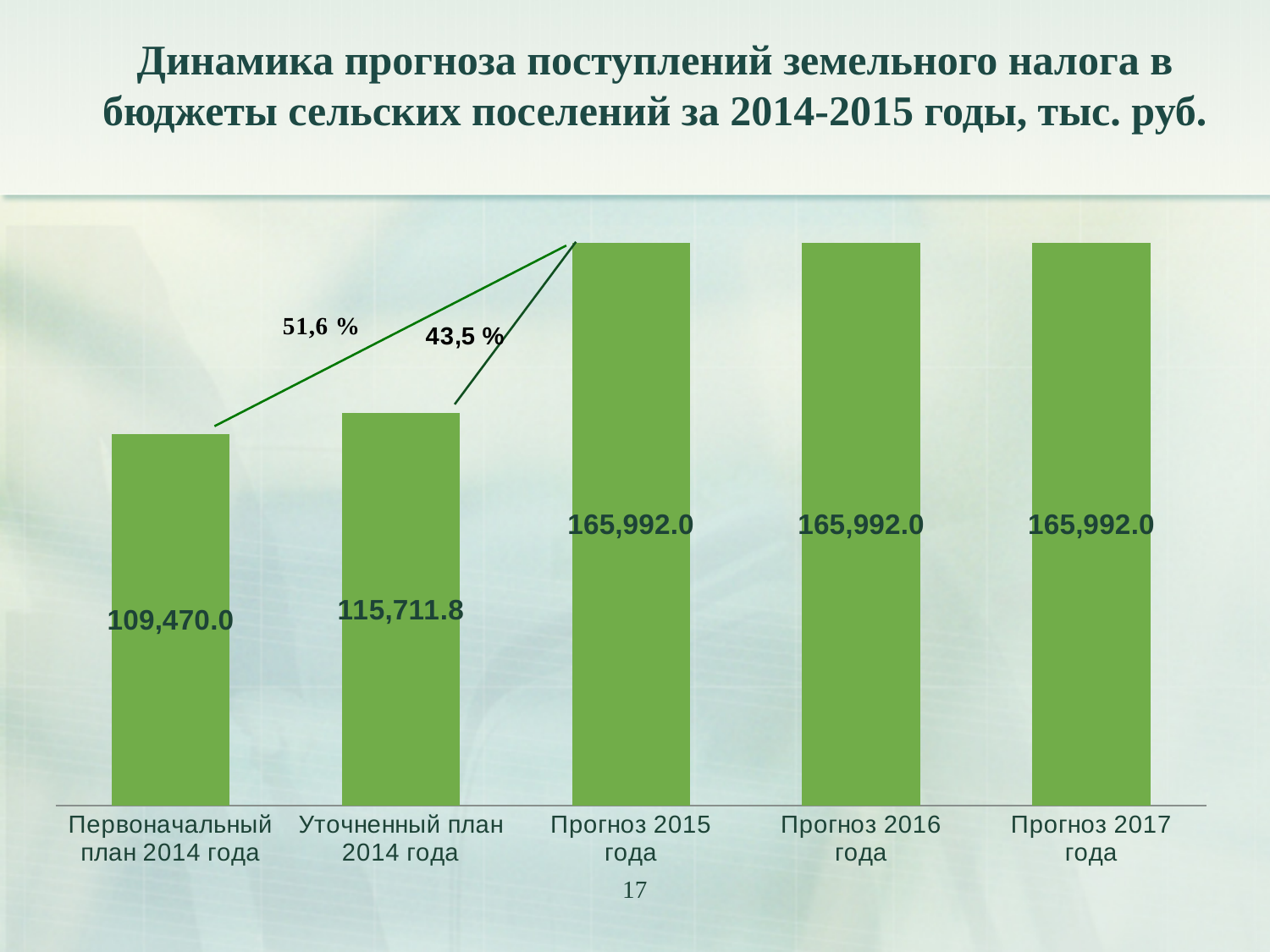
Do the values rise or fall from Первоначальный план 2014 года to Прогноз 2015 года? rise What is the difference between the values for Прогноз 2015 года and Первоначальный план 2014 года? 56,522.0 What is the value for Первоначальный план 2014 года? 109,470.0 What is the difference between the values for Уточненный план 2014 года and Первоначальный план 2014 года? 6,241.8 What is the value for Прогноз 2017 года? 165,992.0 What is the value for Уточненный план 2014 года? 115,711.8 How many categories are shown in the chart? 5 What percentage is written on the annotation line from Уточненный план 2014 года to Прогноз 2015 года? 43,5 % What is the value for Прогноз 2015 года? 165,992.0 Which is larger, the value for Уточненный план 2014 года or the value for Прогноз 2016 года? Прогноз 2016 года What kind of chart is shown on the slide? bar chart Which category has the lowest value? Первоначальный план 2014 года